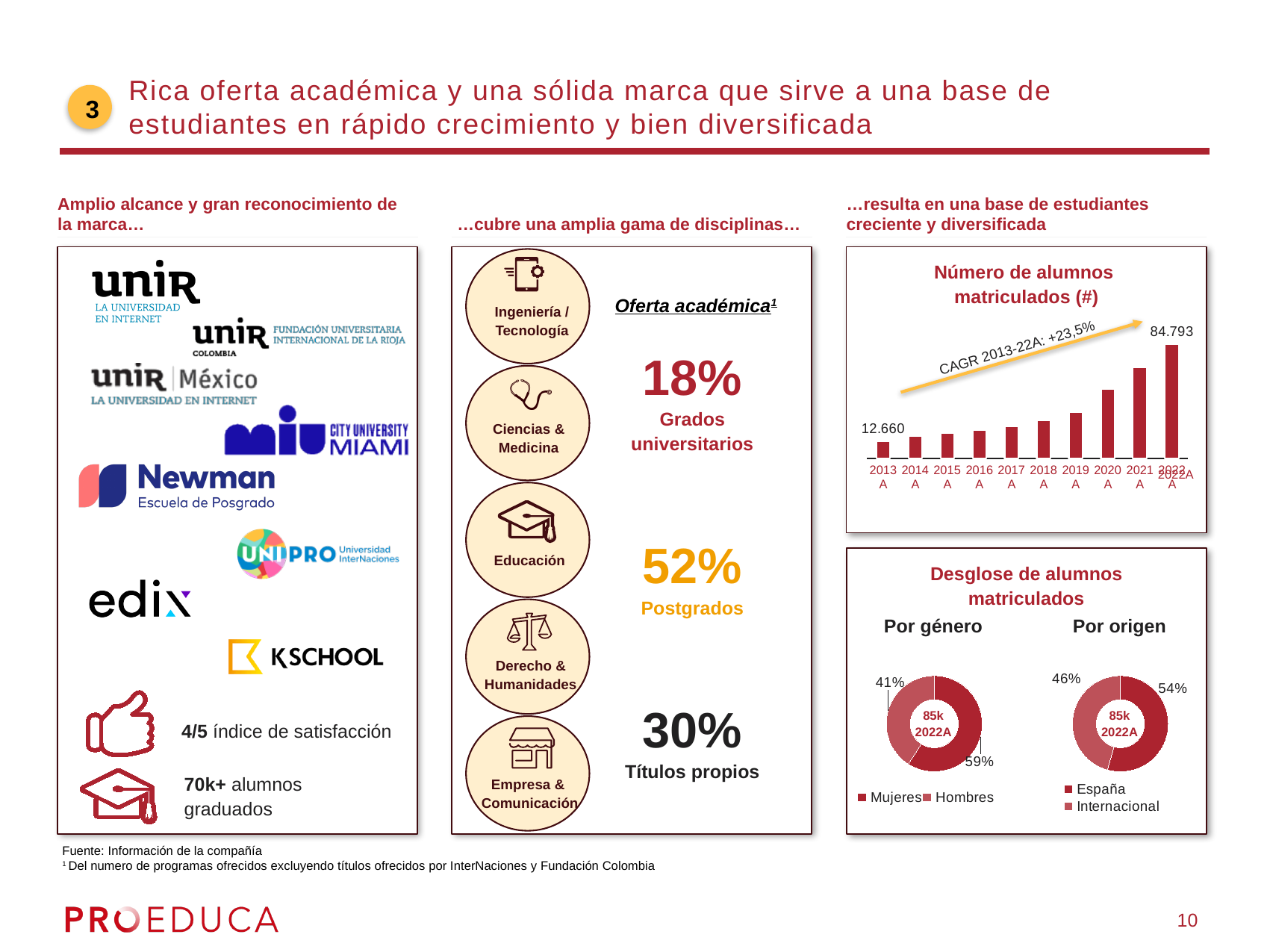
In the 'Número de alumnos matriculados (#)' chart, what is the value for 2013A? 12.660 In the 'Número de alumnos matriculados (#)' chart, which year has the lowest number of students? 2013A In the 'Número de alumnos matriculados (#)' chart, what is the value for 2022A? 84.793 In the 'Por género' donut chart, which group has the larger share, Mujeres or Hombres? Mujeres In the 'Número de alumnos matriculados (#)' chart, which year has the highest number of students? 2022A What CAGR for 2013-22A is annotated on the 'Número de alumnos matriculados (#)' chart? +23,5% What type of chart is 'Número de alumnos matriculados (#)'? bar chart In the 'Número de alumnos matriculados (#)' chart, do the values rise or fall from 2013A to 2022A? rise In the 'Por origen' donut chart, what share is Internacional? 46% In the 'Por origen' donut chart, what share is España? 54% In the 'Número de alumnos matriculados (#)' chart, what is the difference between the 2022A and 2013A values? 72.133 How many years are shown in the 'Número de alumnos matriculados (#)' chart? 10